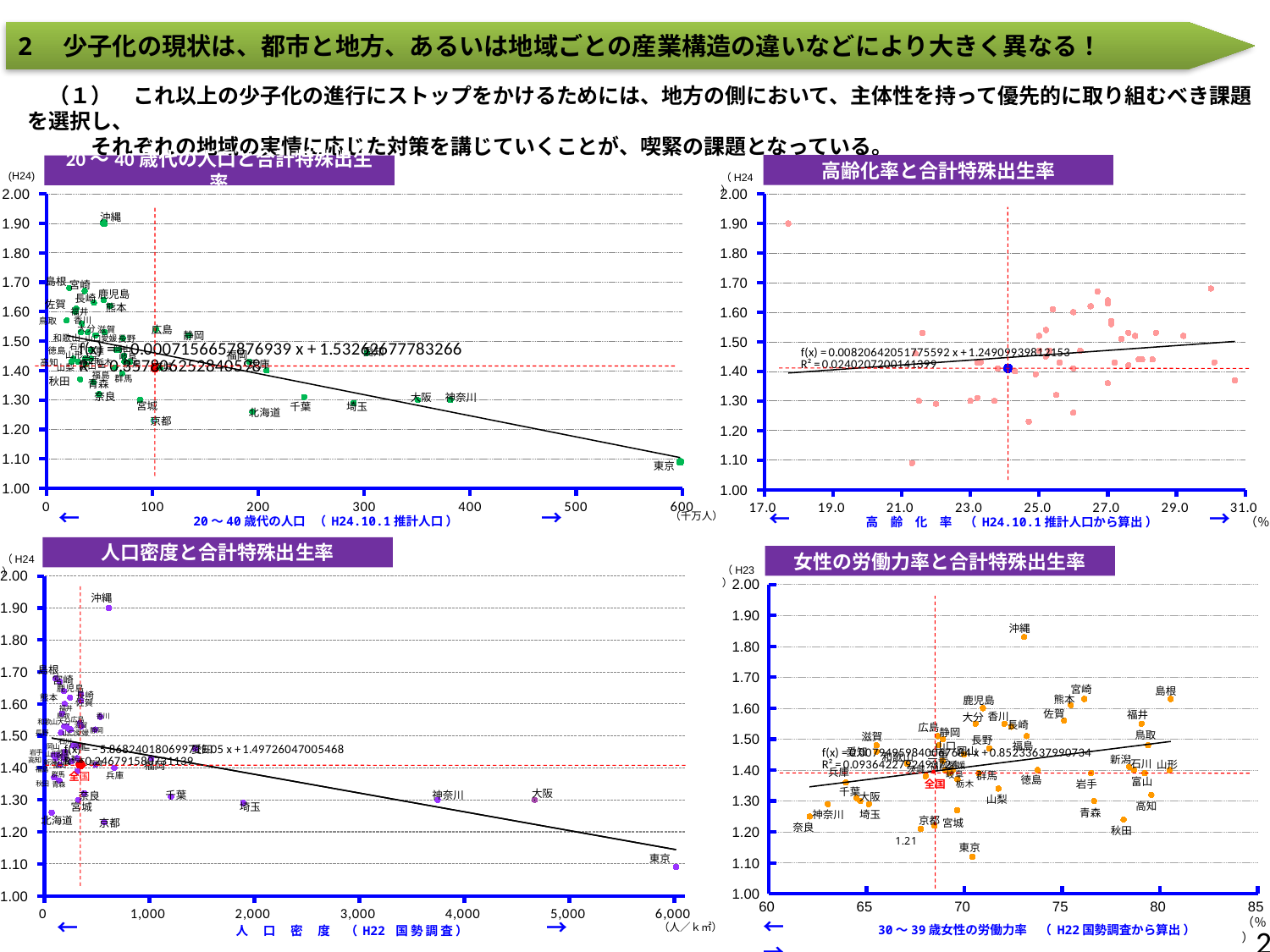
In the bottom-left chart (人口密度と合計特殊出生率), which has the higher fertility rate, 大阪 or 東京? 大阪 What is the title of the top-right chart? 高齢化率と合計特殊出生率 In the top-right chart (高齢化率と合計特殊出生率), does the fitted trend line rise or fall as the x-axis value increases? rise In the bottom-right chart (女性の労働力率と合計特殊出生率), does the fitted trend line rise or fall as the x-axis value increases? rise In the top-left chart (20～40歳代の人口と合計特殊出生率), does the fitted trend line rise or fall as the x-axis value increases? fall In the top-left chart (20～40歳代の人口と合計特殊出生率), is the fertility rate for 沖縄 greater or less than 1.80? greater In the top-left chart (20～40歳代の人口と合計特殊出生率), which labeled prefecture has the lowest fertility rate? 東京 How many charts are shown on the slide? 4 In the bottom-left chart (人口密度と合計特殊出生率), is the fertility rate for 東京 greater or less than 1.20? less In the bottom-right chart (女性の労働力率と合計特殊出生率), which labeled prefecture has the highest fertility rate? 沖縄 What kind of chart is the top-left chart titled 20～40歳代の人口と合計特殊出生率? scatter chart In the top-left chart (20～40歳代の人口と合計特殊出生率), which labeled prefecture has the highest fertility rate? 沖縄